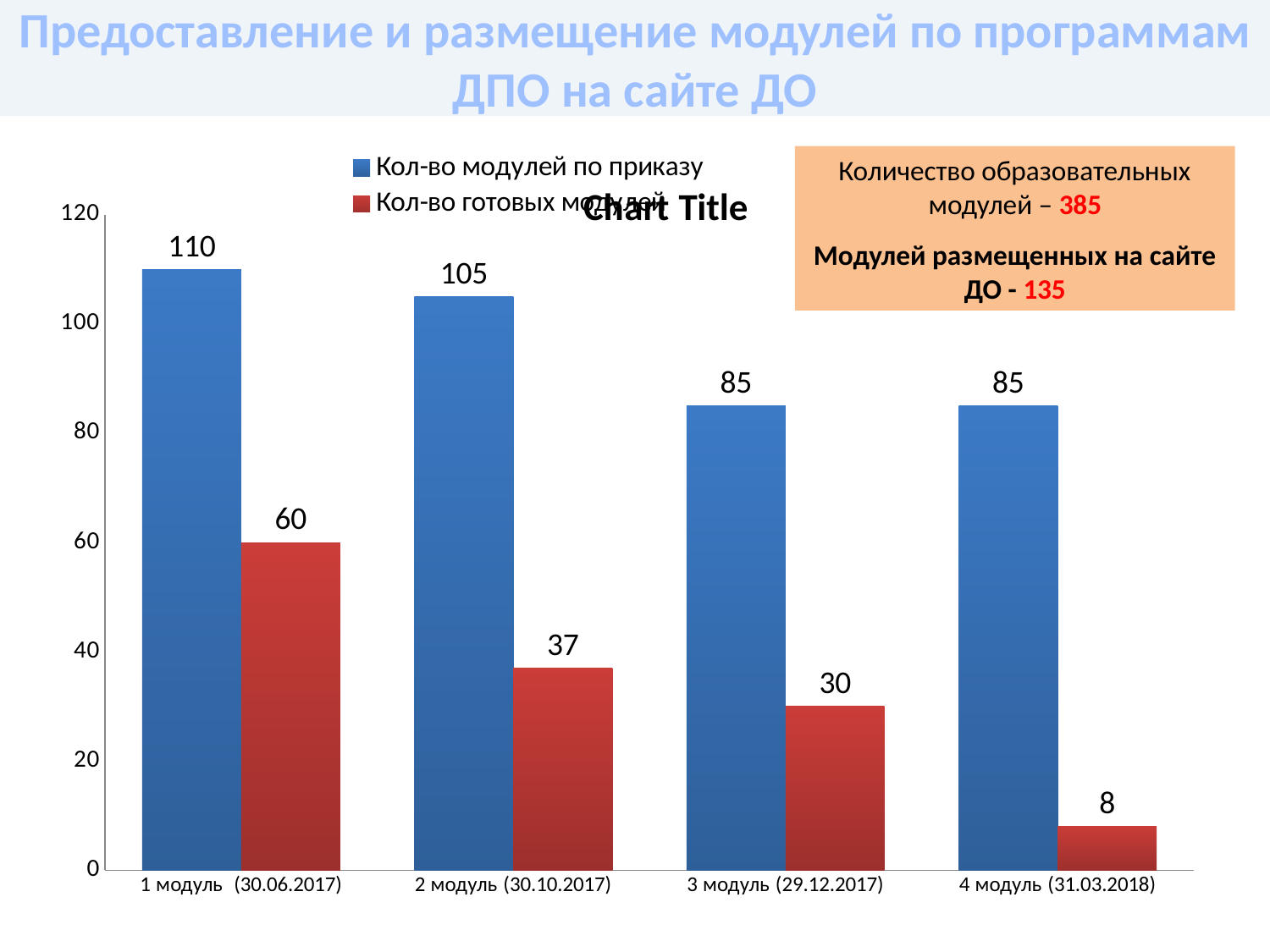
What is the difference between 'Кол-во модулей по приказу' and 'Кол-во готовых модулей' for '3 модуль (29.12.2017)'? 55 What kind of chart is shown on the slide? bar chart How many series does the legend list? 2 Is the value of 'Кол-во модулей по приказу' for '2 модуль (30.10.2017)' greater or less than 100? greater What is the value of 'Кол-во модулей по приказу' for '1 модуль (30.06.2017)'? 110 Which category has the lowest value for 'Кол-во готовых модулей'? 4 модуль (31.03.2018) Which category has the highest value for 'Кол-во модулей по приказу'? 1 модуль (30.06.2017) What is the value of 'Кол-во готовых модулей' for '2 модуль (30.10.2017)'? 37 How many categories are shown on the x axis? 4 Does the value of 'Кол-во готовых модулей' rise or fall from '1 модуль' to '4 модуль'? fall What is the value of 'Кол-во готовых модулей' for '4 модуль (31.03.2018)'? 8 Which is larger: 'Кол-во готовых модулей' for '1 модуль (30.06.2017)' or for '2 модуль (30.10.2017)'? 1 модуль (30.06.2017)